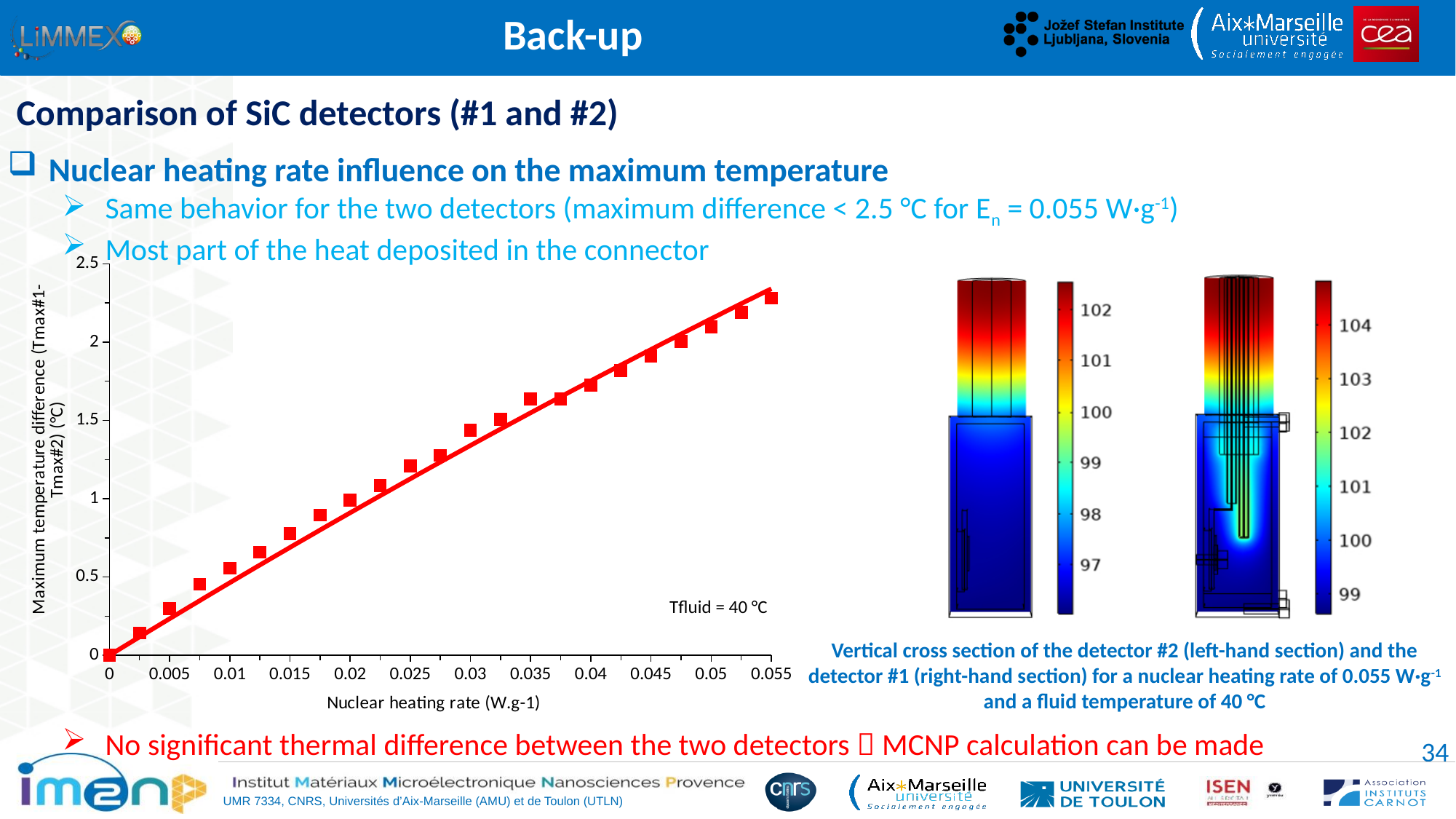
What is the title of the x axis of the chart? Nuclear heating rate (W.g-1) What is the maximum temperature difference at a nuclear heating rate of 0? 0 Is the maximum temperature difference at a nuclear heating rate of 0.03 greater or less than 1? greater At which nuclear heating rate is the maximum temperature difference highest? 0.055 Do the plotted values rise or fall as the nuclear heating rate increases? rise What is the title of the y axis of the chart? Maximum temperature difference (Tmax#1-Tmax#2) (°C) Is the maximum temperature difference at a nuclear heating rate of 0.005 greater or less than 0.5? less Is the maximum temperature difference at a nuclear heating rate of 0.055 greater or less than 2? greater Which is larger, the maximum temperature difference at 0.05 or at 0.01? 0.05 At which nuclear heating rate is the maximum temperature difference lowest? 0 What kind of chart is shown on the left of the slide? scatter chart